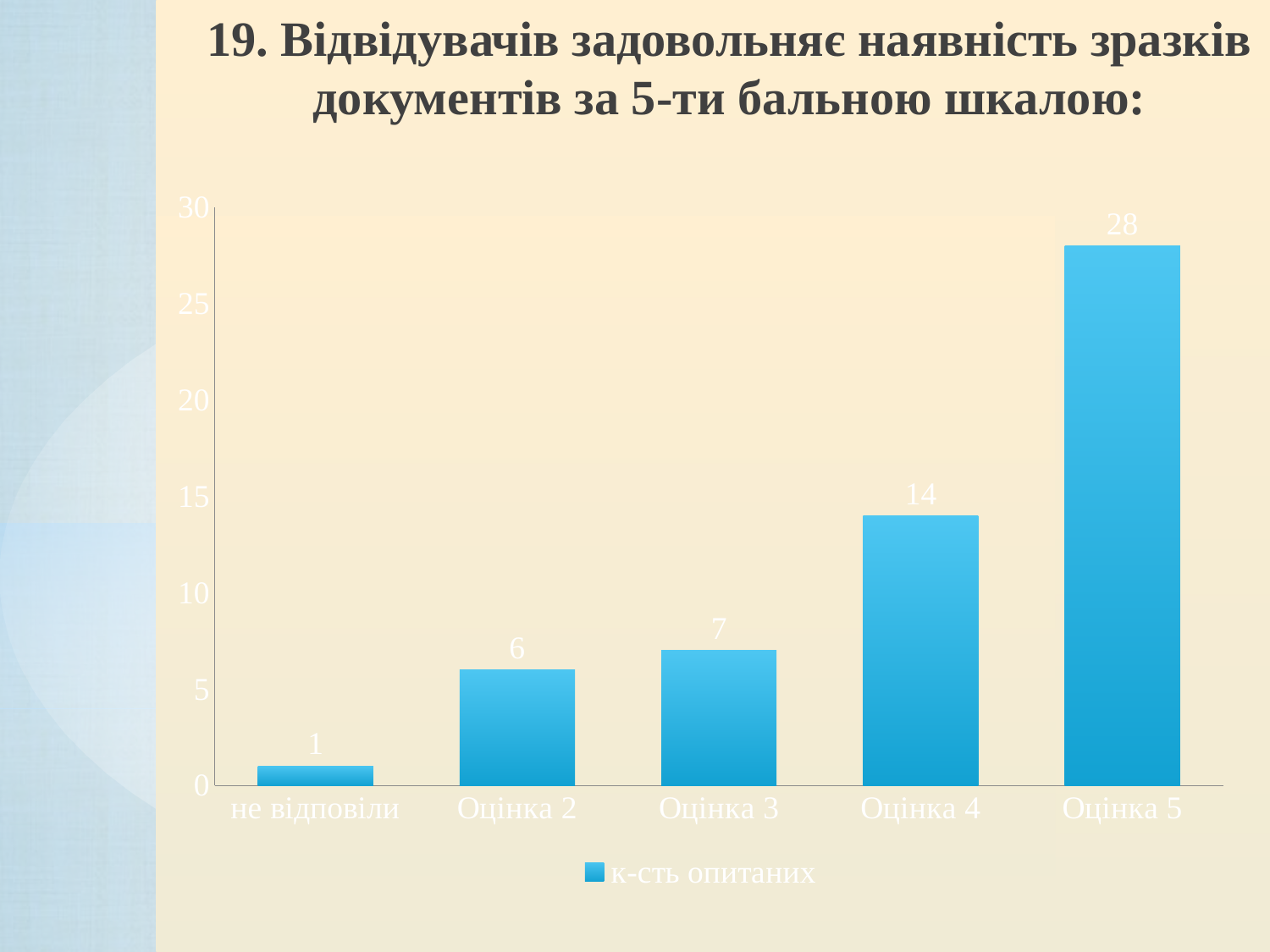
Which category has the highest value? Оцінка 5 What is the difference between the values for Оцінка 5 and Оцінка 4? 14 How many categories are shown on the x axis? 5 Which is larger, the value for Оцінка 3 or the value for Оцінка 2? Оцінка 3 What is the value for не відповіли? 1 What kind of chart is shown on the slide? bar chart What is the value for Оцінка 5? 28 How many series does the legend list? 1 What is the name of the series shown in the legend? к-сть опитаних What is the value for Оцінка 2? 6 Is the value for Оцінка 4 greater or less than 10? greater Which category has the lowest value? не відповіли